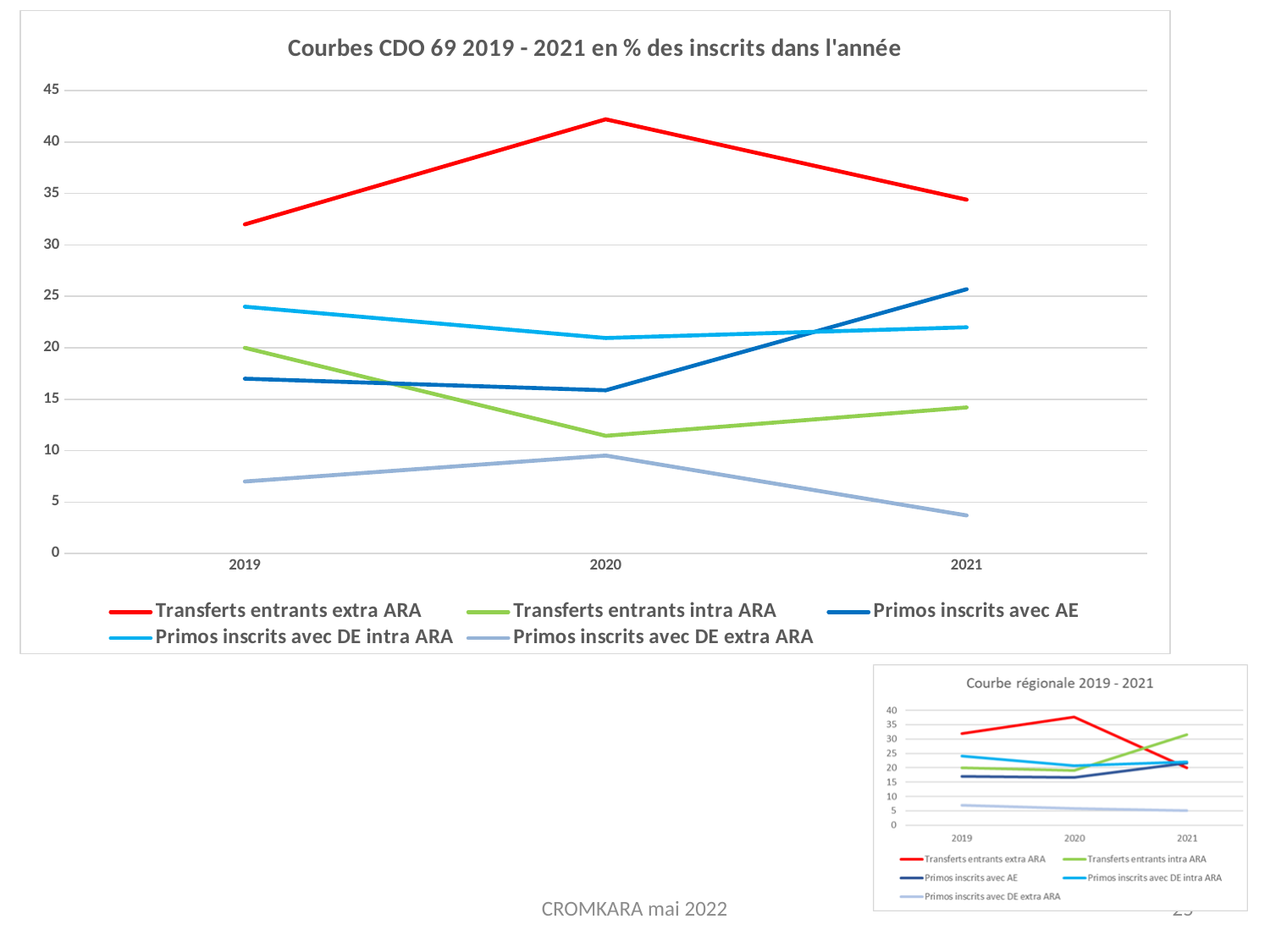
What kind of chart is the large chart titled 'Courbes CDO 69 2019 - 2021 en % des inscrits dans l'année'? line chart On the large chart 'Courbes CDO 69 2019 - 2021', is the value for Primos inscrits avec AE in 2021 greater or less than 20? greater On the large chart 'Courbes CDO 69 2019 - 2021', which series has the highest value in 2020? Transferts entrants extra ARA On the small chart 'Courbe régionale 2019 - 2021', which series has the highest value in 2021? Transferts entrants intra ARA On the large chart 'Courbes CDO 69 2019 - 2021', in 2019 which is larger: Primos inscrits avec DE intra ARA or Transferts entrants intra ARA? Primos inscrits avec DE intra ARA On the large chart 'Courbes CDO 69 2019 - 2021', which series has the lowest value in 2021? Primos inscrits avec DE extra ARA What is the title of the small chart in the lower right of the slide? Courbe régionale 2019 - 2021 On the large chart 'Courbes CDO 69 2019 - 2021', does the value for Primos inscrits avec DE extra ARA rise or fall from 2020 to 2021? fall On the small chart 'Courbe régionale 2019 - 2021', does the value for Transferts entrants extra ARA rise or fall from 2020 to 2021? fall On the large chart 'Courbes CDO 69 2019 - 2021', how many series does the legend list? 5 On the large chart 'Courbes CDO 69 2019 - 2021', is the value for Transferts entrants extra ARA in 2020 greater or less than 40? greater On the large chart 'Courbes CDO 69 2019 - 2021', how many years are shown on the x axis? 3